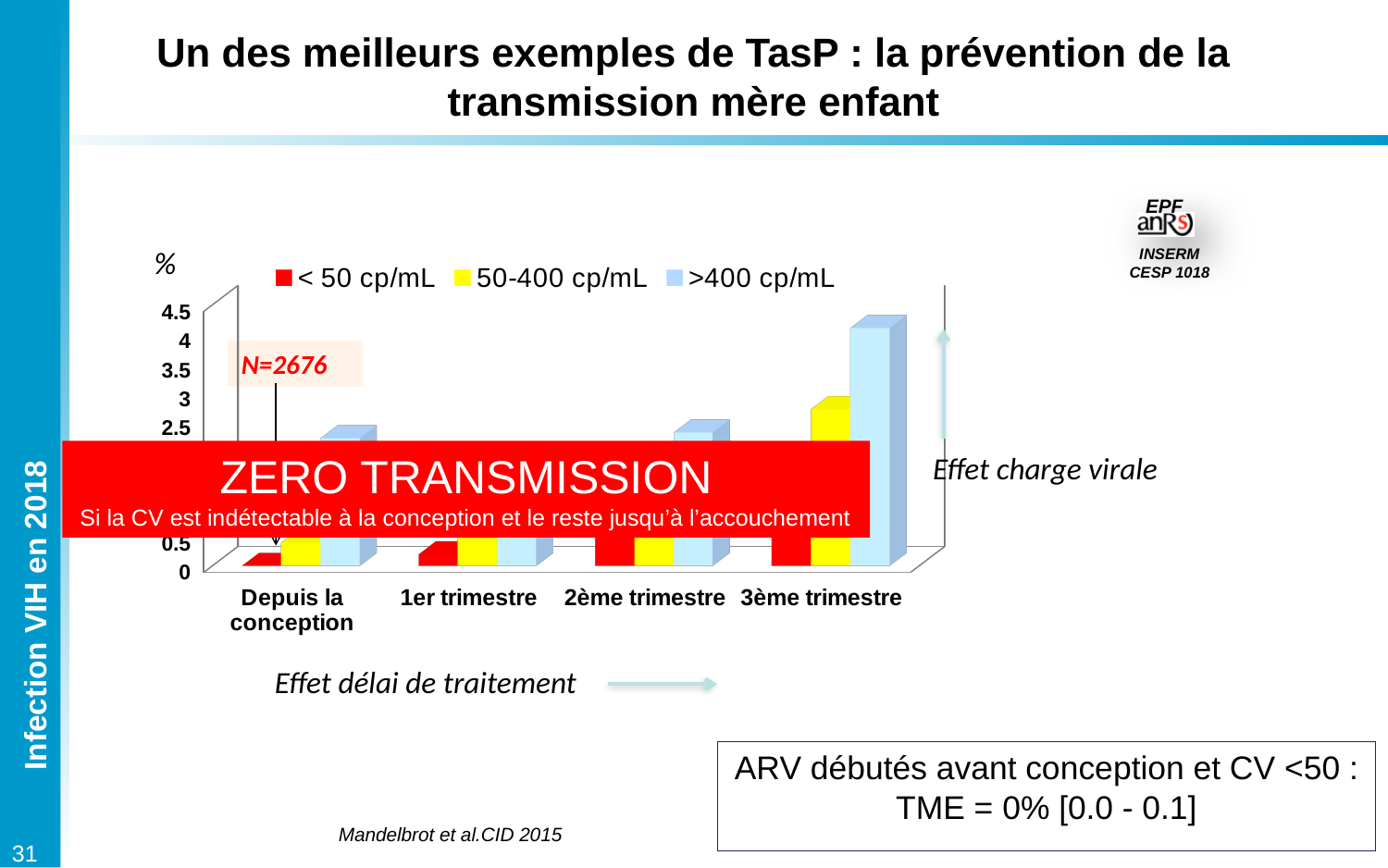
What sample size (N) is annotated on the chart? N=2676 Which is larger in 3ème trimestre: the >400 cp/mL value or the 50-400 cp/mL value? >400 cp/mL Is the value for >400 cp/mL in 3ème trimestre greater or less than 4? greater How many categories are shown on the x axis of the chart? 4 How many series does the chart legend list? 3 Which series is shown in red in the chart legend? < 50 cp/mL Which is larger for the >400 cp/mL series: 2ème trimestre or 3ème trimestre? 3ème trimestre Which category has the lowest value for the < 50 cp/mL series? Depuis la conception Which category has the highest value for the >400 cp/mL series? 3ème trimestre Is the value for 50-400 cp/mL in 3ème trimestre greater or less than 2.5? greater What kind of chart is shown on the slide? bar chart Is the value for >400 cp/mL in Depuis la conception greater or less than 3? less